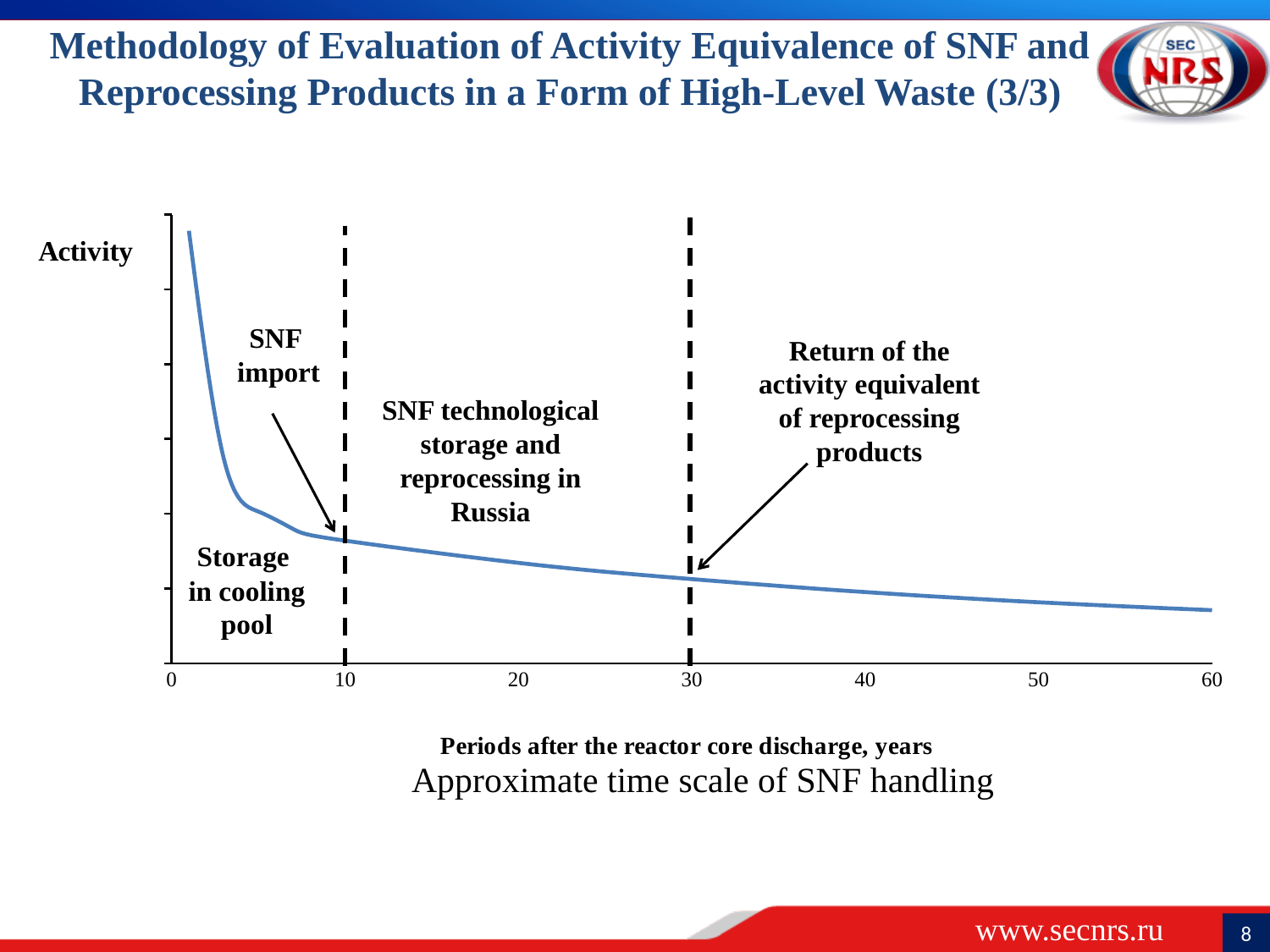
At how many years after discharge does the 'SNF import' annotation point on the curve? 10 Which period is labelled between 10 and 30 years on the chart? SNF technological storage and reprocessing in Russia What is the label of the x axis? Periods after the reactor core discharge, years Is the activity higher at 10 years or at 30 years after discharge? 10 years What is the label of the y axis? Activity Is the activity higher at the start of the curve or at 60 years? at the start Which period is labelled before 10 years on the chart? Storage in cooling pool At how many years after discharge does the 'Return of the activity equivalent of reprocessing products' annotation point on the curve? 30 Does the activity rise or fall as the number of years after reactor core discharge increases? fall What is the largest value shown on the x axis? 60 How many vertical dashed lines divide the chart into periods? 2 What kind of chart is shown on the slide? line chart